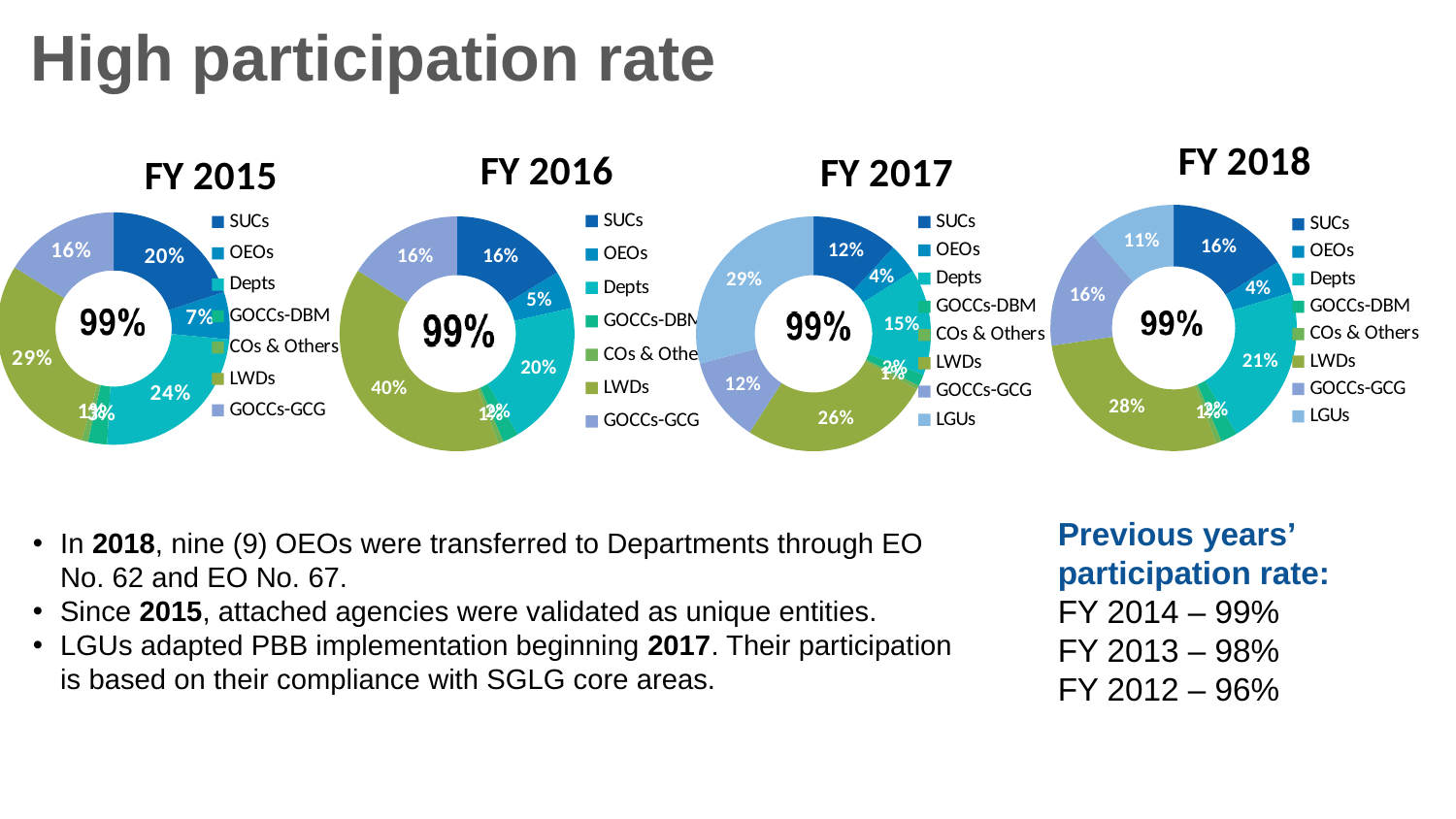
In the FY 2017 chart, what share is shown for LGUs? 29% In the FY 2018 chart, which is larger, the share for Depts or the share for LGUs? Depts In the FY 2015 chart, what share is shown for Depts? 24% How many entries does the legend of the FY 2015 chart list? 7 How many entries does the legend of the FY 2017 chart list? 8 In the FY 2016 chart, which category has the largest share? LWDs In the FY 2018 chart, what share is shown for SUCs? 16% In the FY 2017 chart, what is the difference between the share for LWDs and the share for SUCs? 14% What kind of chart is used for FY 2018? Doughnut (pie) chart In the FY 2015 chart, which category has the largest share? LWDs What value is printed in the centre of the FY 2016 chart? 99% In the FY 2016 chart, what share is shown for LWDs? 40%